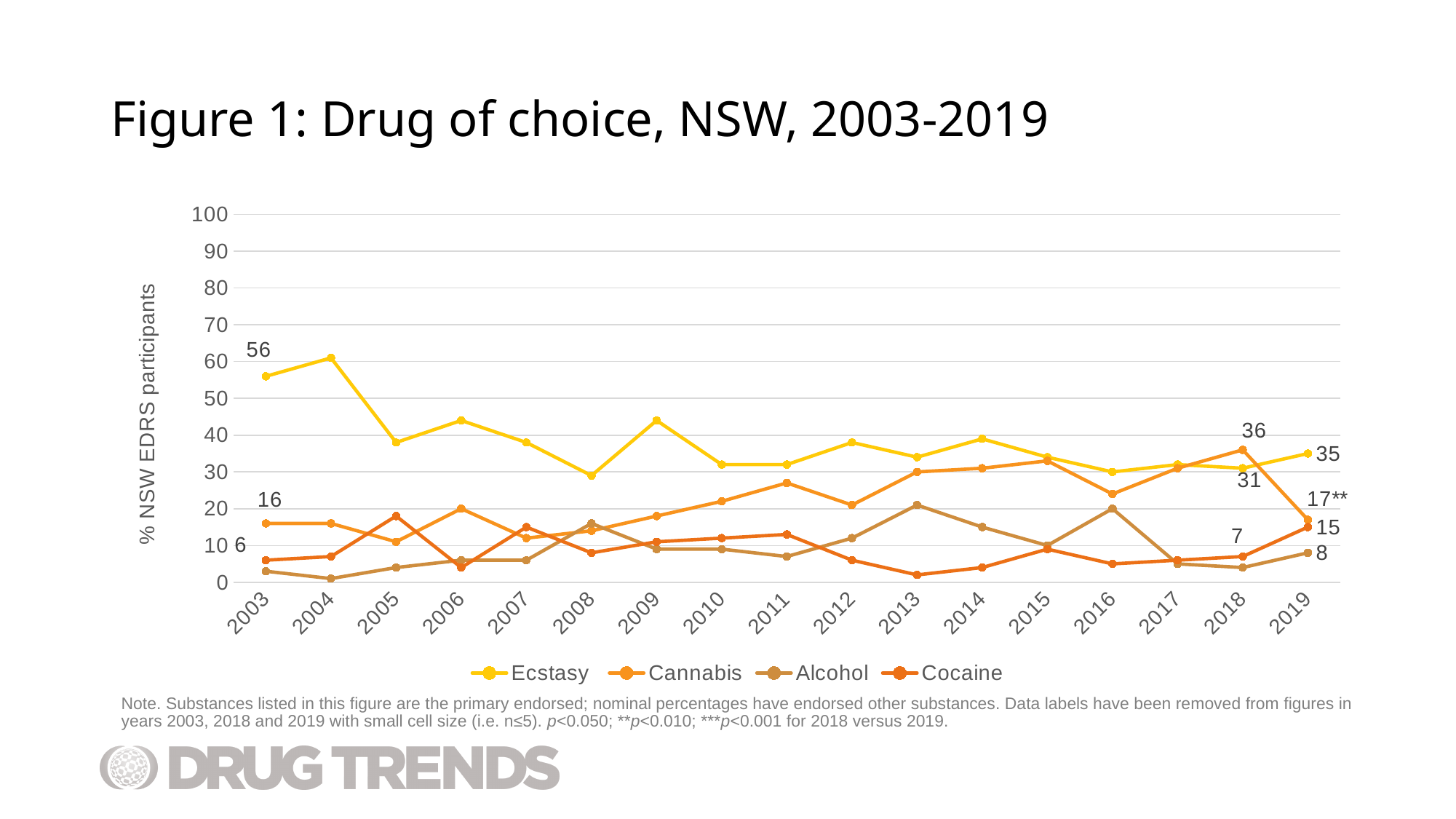
Is the value for Ecstasy in 2004 greater or less than 50? greater How many series does the legend list? 4 In 2018, how much higher is the Cannabis value than the Ecstasy value? 5 Which series has the highest value in 2003? Ecstasy What kind of chart is shown on the slide? line chart What is the difference between the Ecstasy values in 2003 and 2019? 21 What is the value for Ecstasy in 2003? 56 What is the value for Cannabis in 2018? 36 What is the value for Cocaine in 2018? 7 What is the value for Ecstasy in 2019? 35 What is the value for Alcohol in 2019? 8 In 2019, which is larger: the value for Ecstasy or the value for Cocaine? Ecstasy